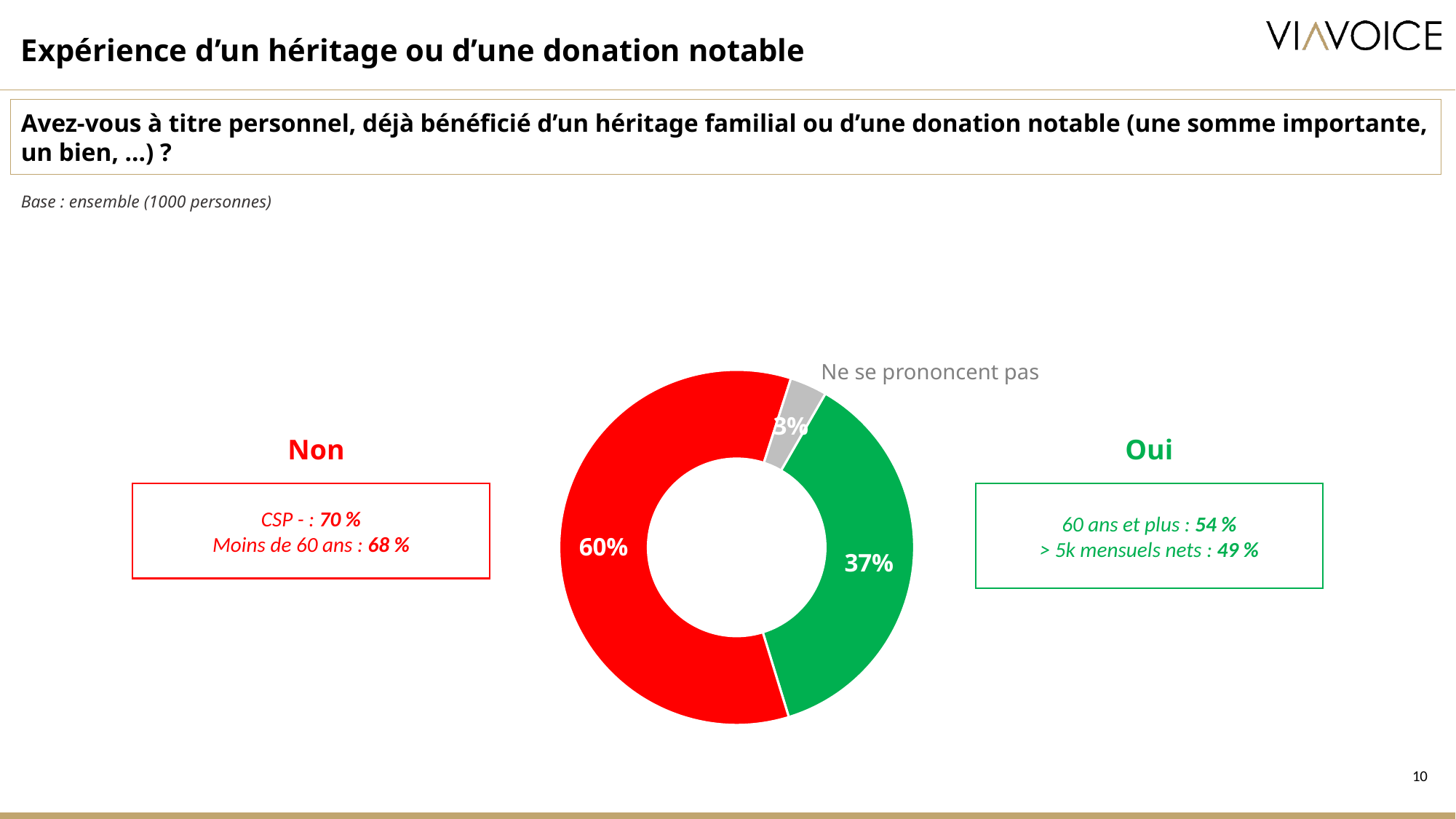
Which is larger, the "Oui" slice or the "Non" slice? Non What share of respondents is shown for "Ne se prononcent pas"? 3% What share of respondents answered "Oui" in the donut chart? 37% How many slices does the donut chart have? 3 What colour is the "Non" slice of the donut chart? Red What colour is the "Oui" slice of the donut chart? Green What type of chart is shown on the slide? Donut (pie) chart What share of respondents answered "Non" in the donut chart? 60% Which slice of the donut chart is the smallest? Ne se prononcent pas Which slice of the donut chart is the largest? Non What is the difference in percentage points between the "Non" and "Oui" slices? 23 What is the combined share of the "Oui" and "Ne se prononcent pas" slices? 40%